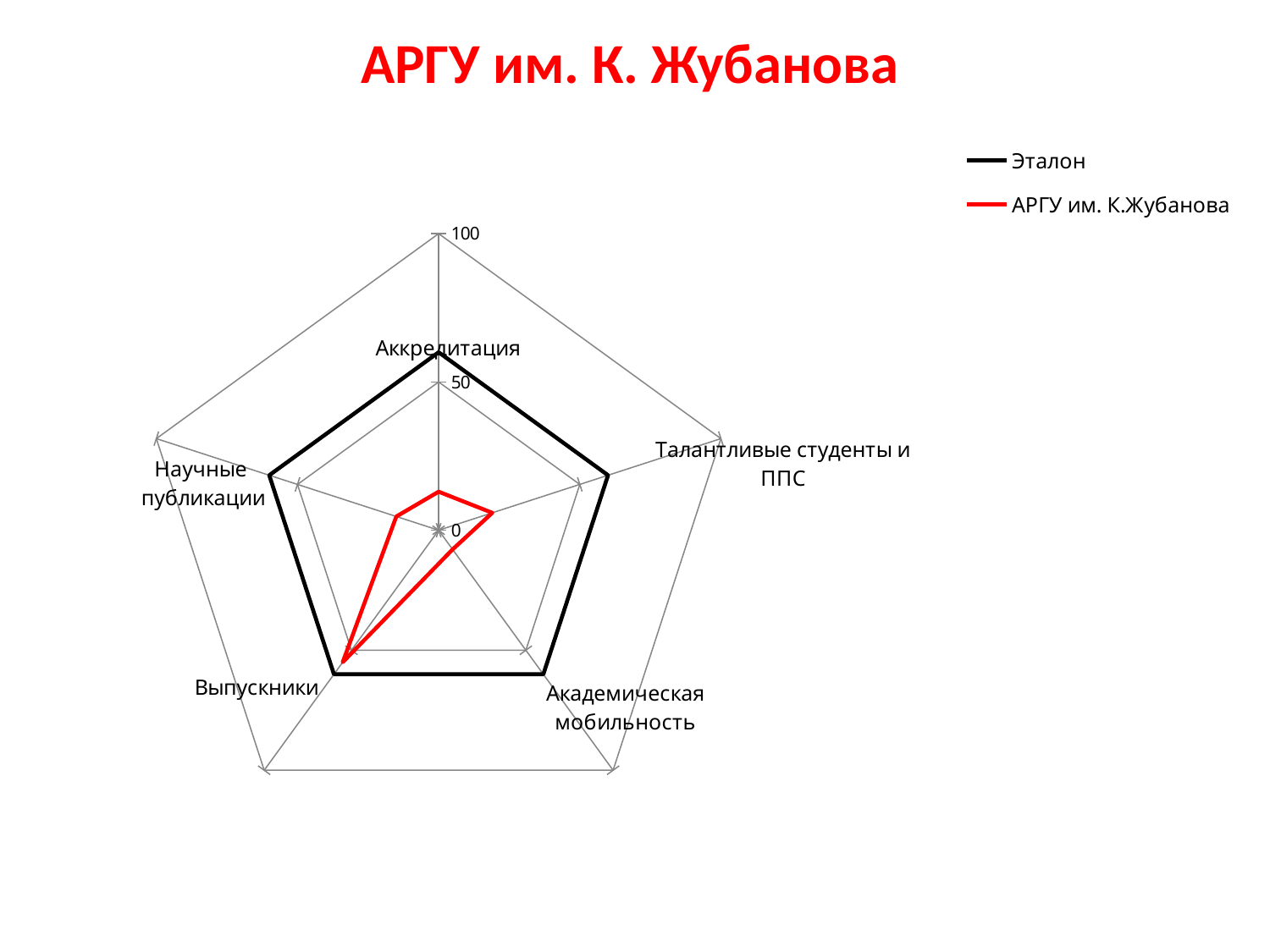
Is the value of Эталон for Аккредитация greater or less than 50? greater Is the value of АРГУ им. К.Жубанова for Выпускники greater or less than 50? greater How many series does the legend list? 2 For Аккредитация, which series has the larger value: Эталон or АРГУ им. К.Жубанова? Эталон For the series АРГУ им. К.Жубанова, which is larger: the value for Выпускники or the value for Научные публикации? Выпускники How many categories (axes) does the radar chart have? 5 For the series АРГУ им. К.Жубанова, which category has the lowest value? Академическая мобильность What kind of chart is shown on the slide? Radar chart Is the value of АРГУ им. К.Жубанова for Талантливые студенты и ППС greater or less than 50? less For the series АРГУ им. К.Жубанова, which category has the highest value? Выпускники What colour is the line for the Эталон series? Black